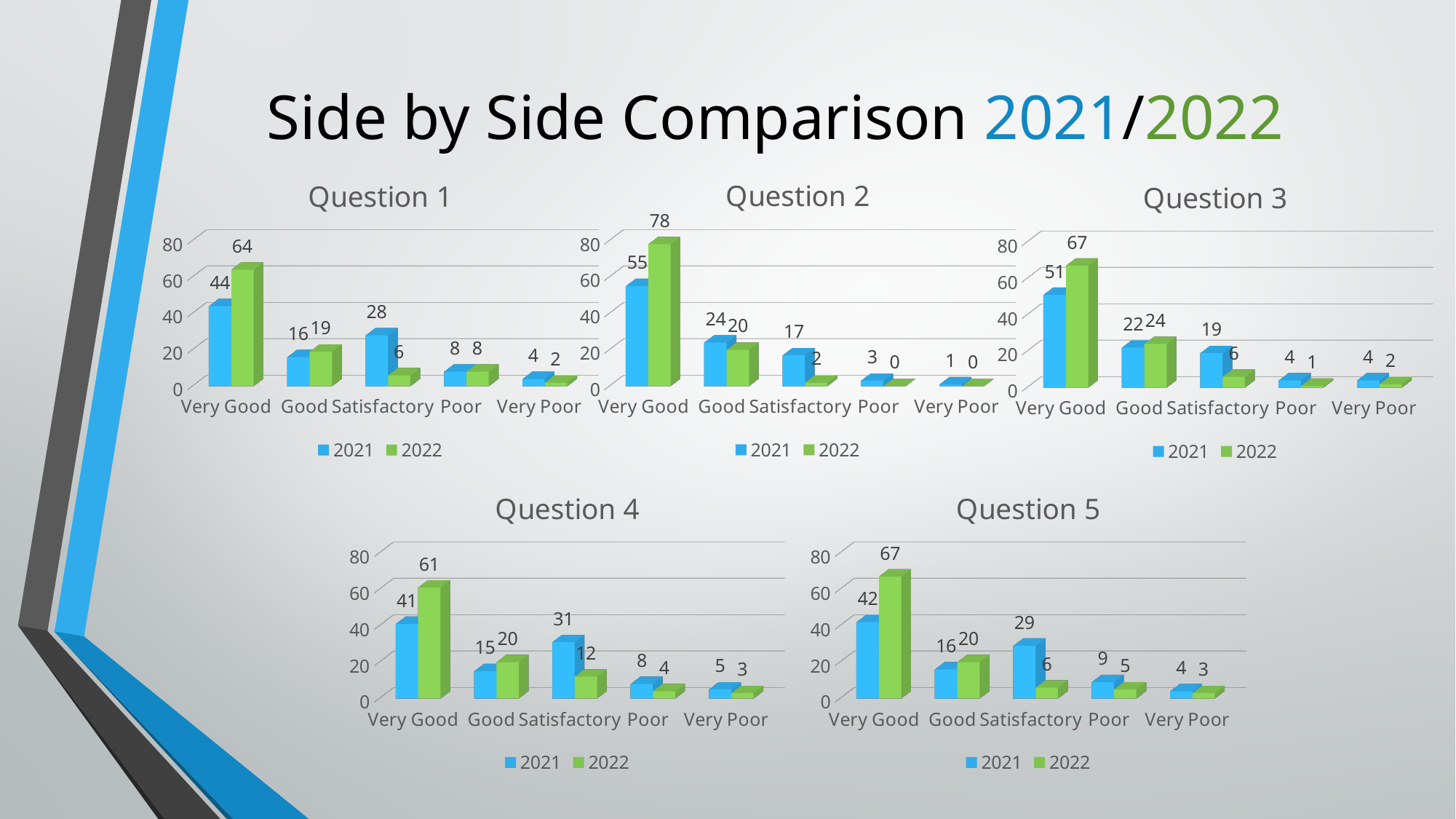
In the Question 3 chart, how many series does the legend list? 2 Which colour represents the 2022 series in the Question 2 chart? Green In the Question 2 chart, what is the 2021 value for Satisfactory? 17 In the Question 1 chart, what is the 2022 value for Very Good? 64 In the Question 2 chart, which category has the lowest 2022 value? Poor and Very Poor (both 0) In the Question 1 chart, how many categories are shown on the x axis? 5 In the Question 3 chart, which category has the highest 2022 value? Very Good In the Question 3 chart, what is the 2021 value for Good? 22 In the Question 5 chart, which is larger for Satisfactory: the 2021 value or the 2022 value? 2021 What type of chart is the Question 4 chart? Bar chart In the Question 5 chart, do the 2022 values rise or fall from Very Good to Very Poor? Fall In the Question 4 chart, what is the difference between the 2022 and 2021 values for Very Good? 20